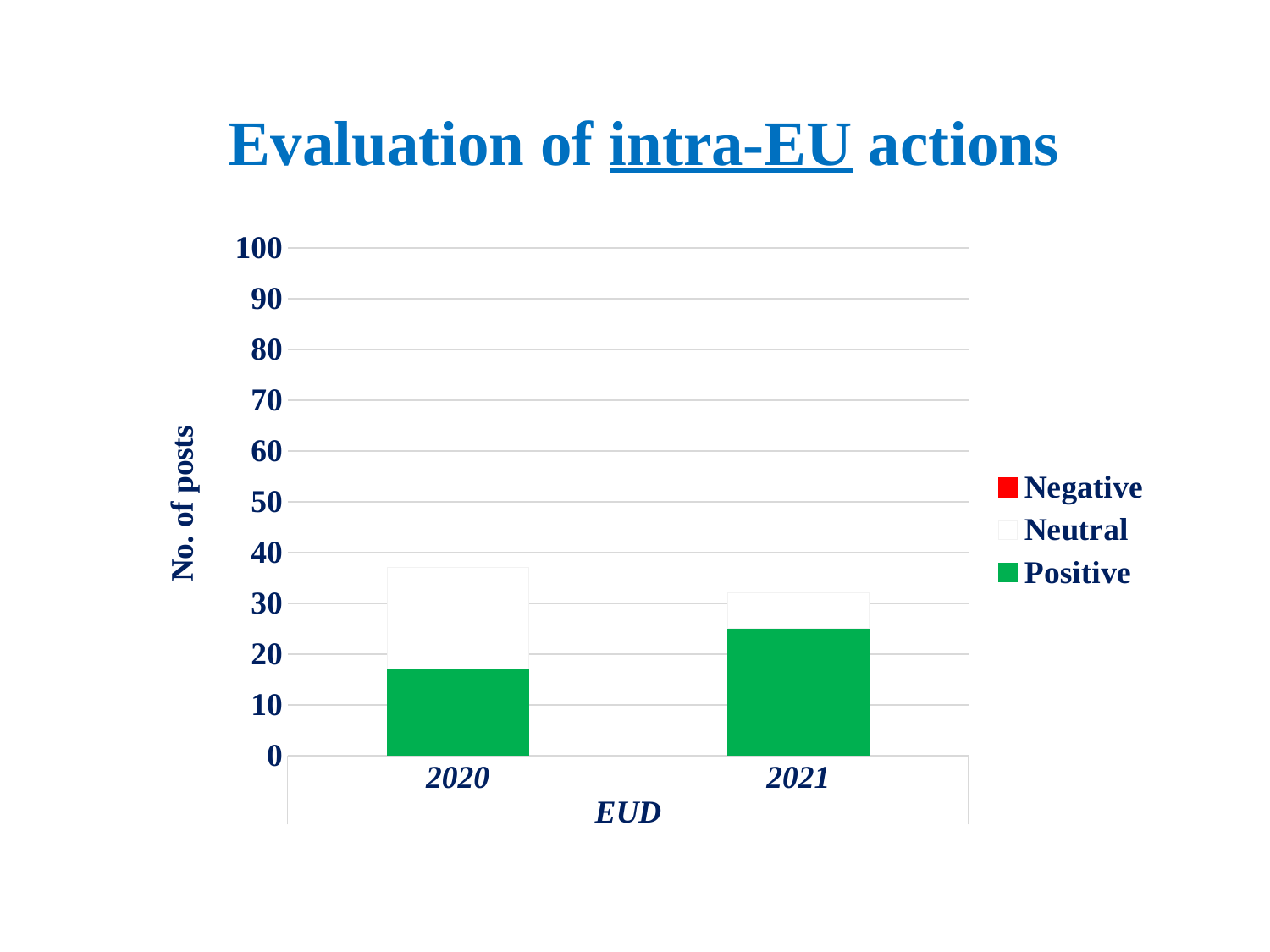
Is the Positive value for 2021 greater or less than 20? greater Which year has the larger Neutral segment, 2020 or 2021? 2020 Is the total height of the stacked bar for 2021 greater or less than 40? less What kind of chart is shown on the slide? bar chart How many categories are shown on the x axis? 2 Is the Positive value for 2021 greater or less than 30? less How many series does the legend list? 3 What is the label on the y axis? No. of posts What is the title of the chart on the slide? Evaluation of intra-EU actions Which year has the larger Positive value, 2020 or 2021? 2021